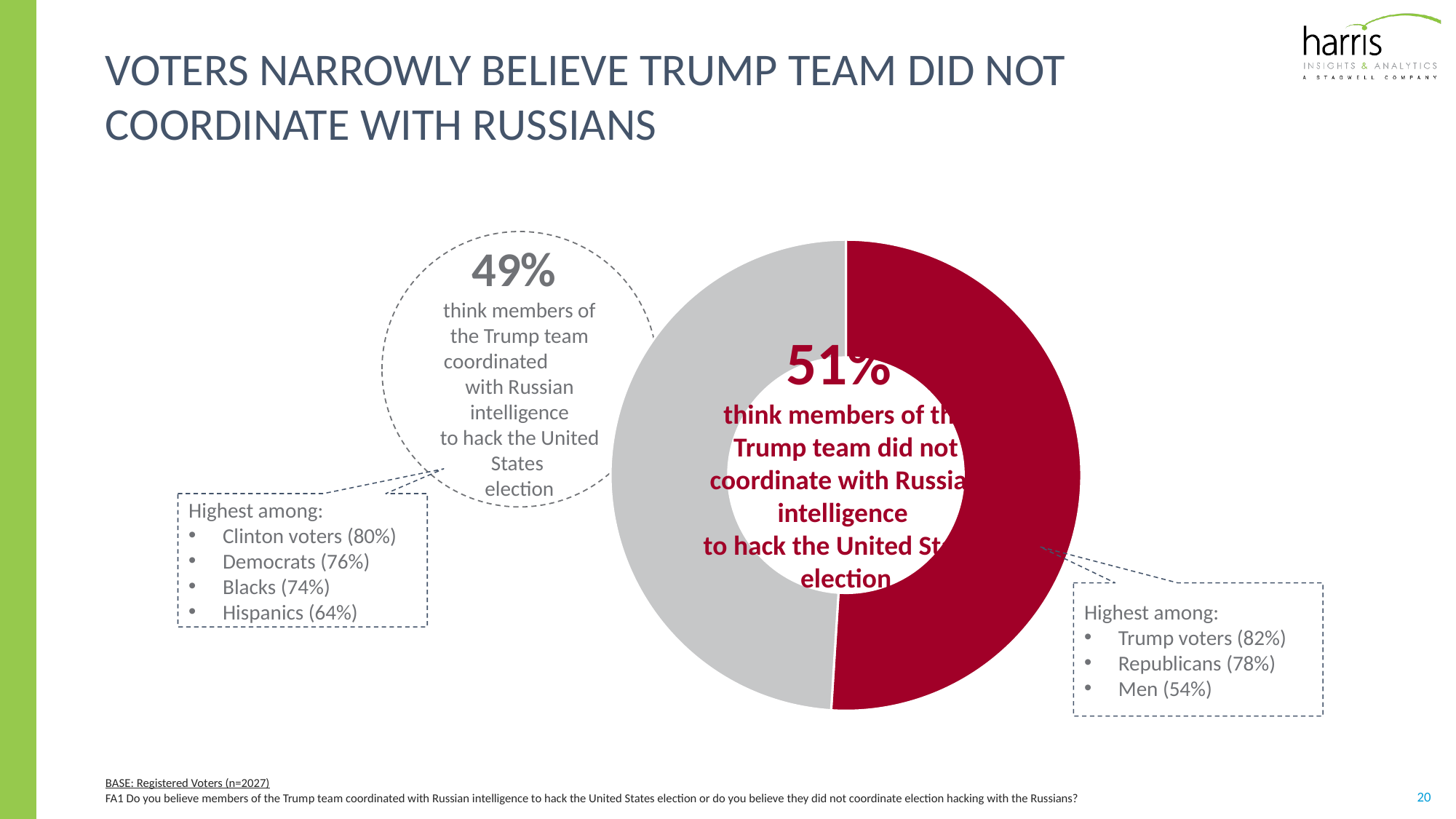
How many slices does the pie chart have? 2 What is the difference in percentage points between the share who think the Trump team did not coordinate and the share who think it did? 2 percentage points Which view holds the larger share of the pie: that the Trump team coordinated with Russian intelligence, or that it did not? did not coordinate (51%) According to the callout, what percentage of Trump voters think the Trump team did not coordinate with Russian intelligence? 82% What percentage of voters think members of the Trump team did not coordinate with Russian intelligence to hack the election? 51% What do the two slices of the pie chart add up to? 100% What percentage of voters think members of the Trump team coordinated with Russian intelligence to hack the election? 49% According to the callouts, what percentage of Men think the Trump team did not coordinate with Russian intelligence? 54% What colour is the slice representing the 51% who think the Trump team did not coordinate with Russian intelligence? red What kind of chart is shown on the slide? pie chart (donut) According to the callout, what percentage of Clinton voters think the Trump team coordinated with Russian intelligence? 80% Which is higher: the share of Republicans who think the Trump team did not coordinate, or the share of Democrats who think it did coordinate? Republicans (78%)